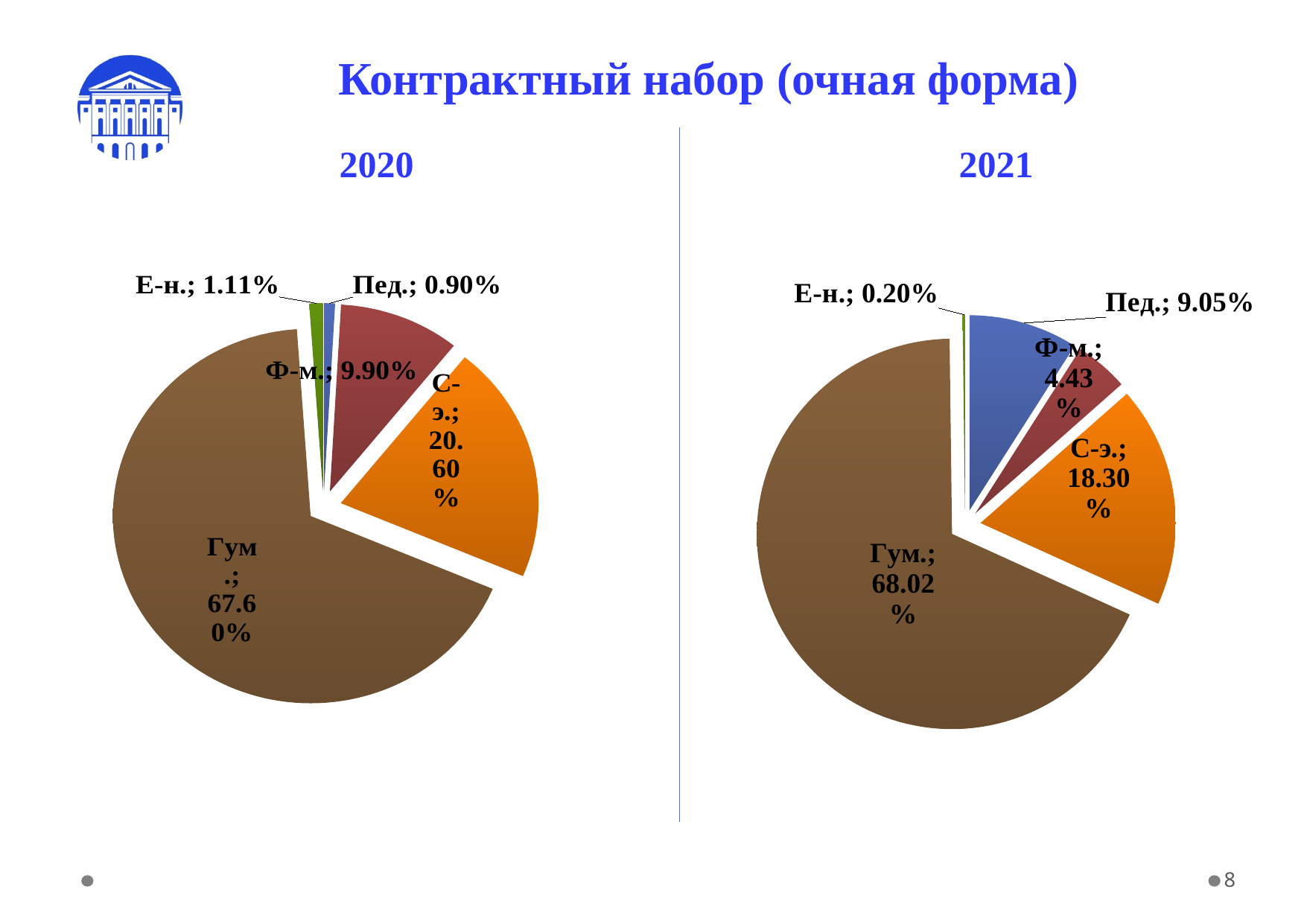
In the 2021 pie chart, what is the value for Пед.? 9.05% In the 2021 pie chart, which is larger: Пед. or Ф-м.? Пед. How many slices does the 2021 pie chart have? 5 In the 2020 pie chart, which category has the smallest share? Пед. In the 2020 pie chart, what is the value for Ф-м.? 9.90% In the 2020 pie chart, what share does Гум. have? 67.60% What is the title of the slide containing the two charts? Контрактный набор (очная форма) In the 2021 pie chart, what is the value for Е-н.? 0.20% In the 2021 pie chart, what share does С-э. have? 18.30% In the 2020 pie chart, what is the difference between the shares of С-э. and Ф-м.? 10.70% In the 2021 pie chart, which category has the largest share? Гум. What type of chart is used for the 2020 data? Pie chart